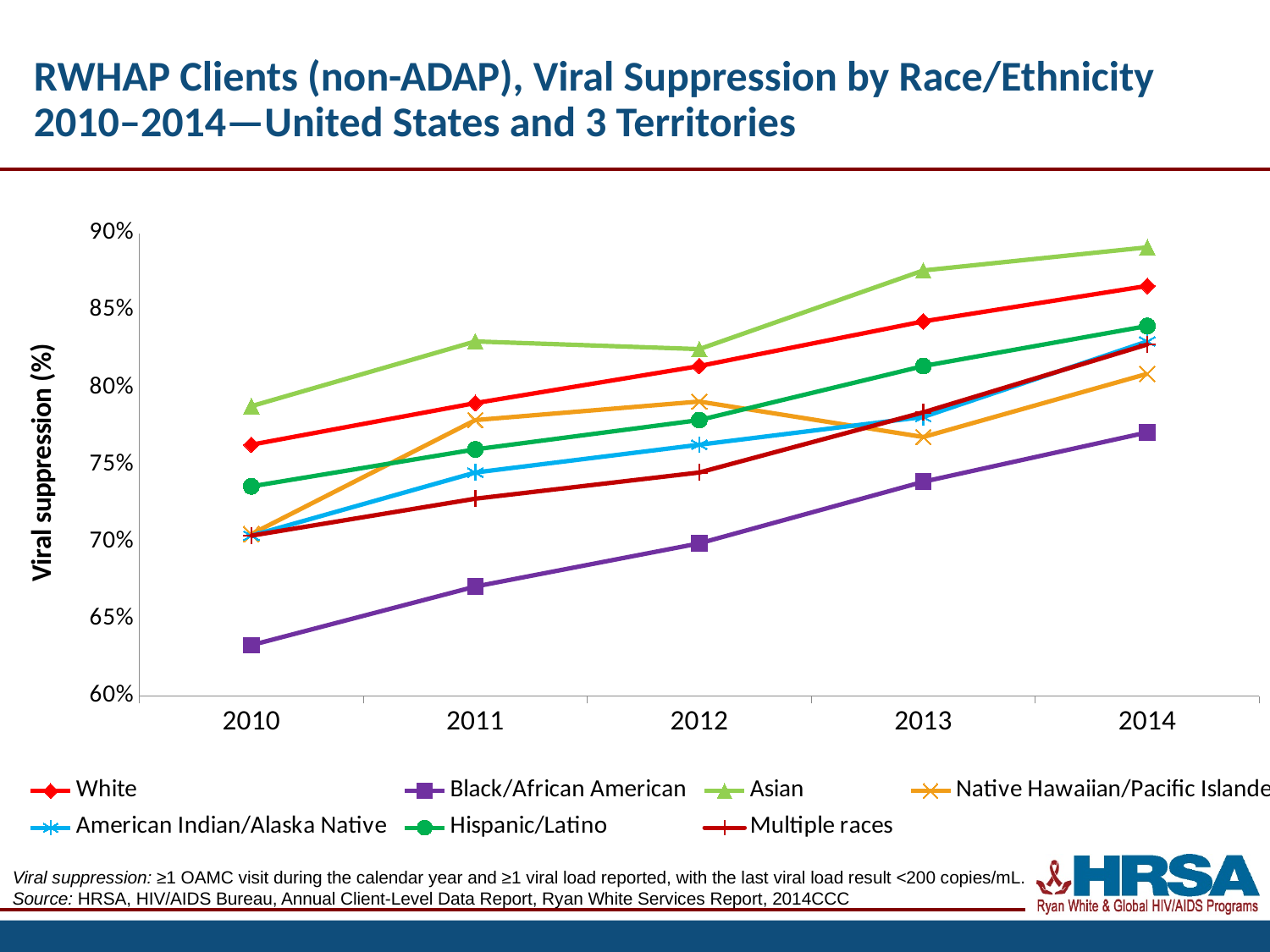
In 2013, which group has higher viral suppression, White or Hispanic/Latino? White Does viral suppression for Black/African American clients rise or fall from 2010 to 2014? rise Is the viral suppression value for Asian clients in 2014 greater or less than 85%? greater What kind of chart is shown on the slide? line chart Which race/ethnicity group has the highest viral suppression in 2014? Asian Is the viral suppression value for White clients in 2012 greater or less than 80%? greater Is the viral suppression value for Black/African American clients in 2010 greater or less than 65%? less Which race/ethnicity group has the lowest viral suppression in 2010? Black/African American How many years are plotted along the x axis? 5 Which race/ethnicity group has the lowest viral suppression in 2014? Black/African American How many race/ethnicity series does the legend list? 7 What is the label on the y axis of the chart? Viral suppression (%)